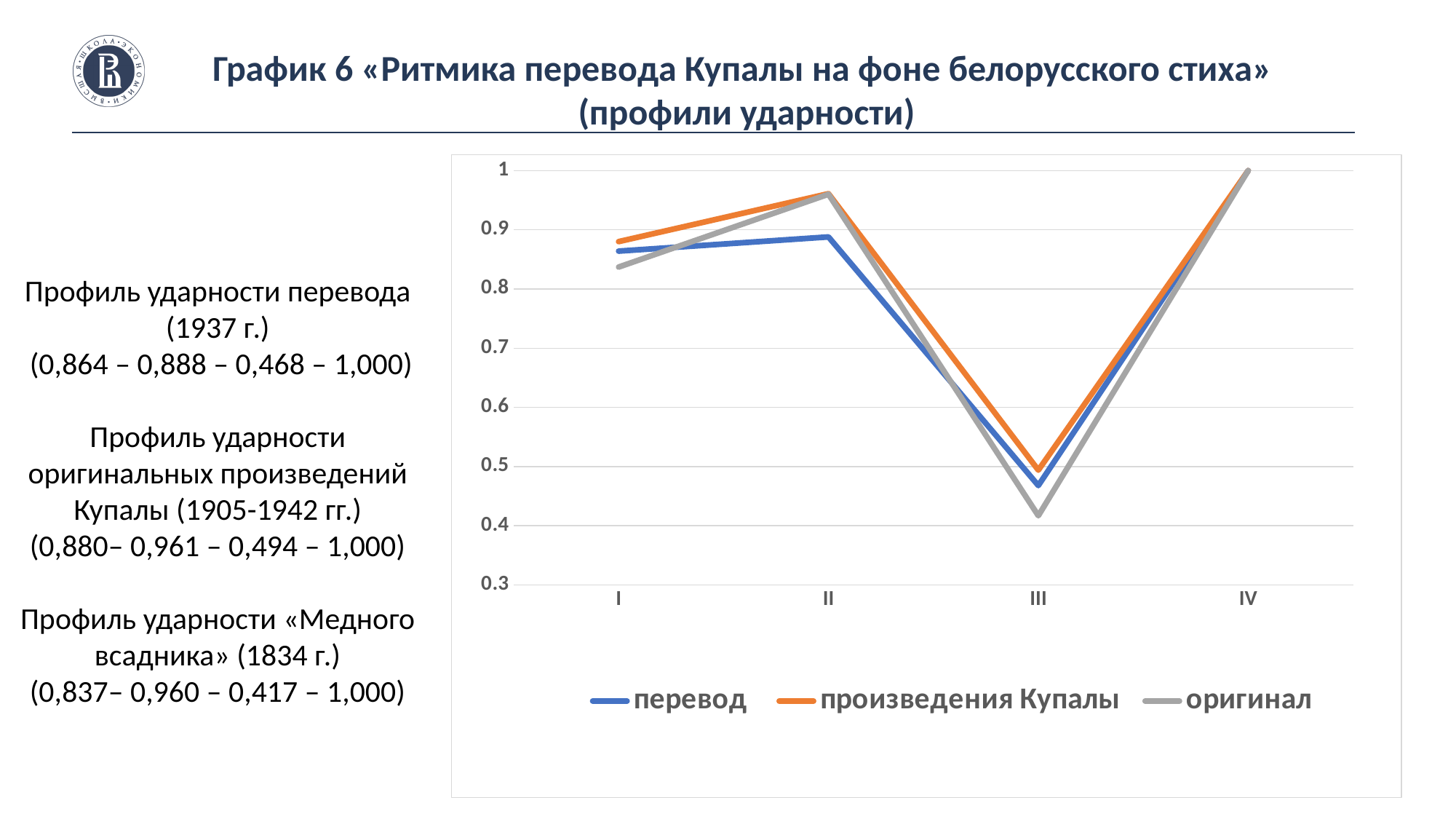
Which series has the lowest value at position III? оригинал What is the difference between the произведения Купалы and оригинал values at position III? 0,077 Do the values of all three series rise or fall from position II to position III? fall At which position does the оригинал series reach its lowest value? III Is the value of the перевод series at position III greater or less than 0.5? less What type of chart is shown on the slide? line chart How many series does the legend of the chart list? 3 At position II, which is larger: перевод or произведения Купалы? произведения Купалы What is the value of the перевод series at position III? 0,468 What is the value of the произведения Купалы series at position II? 0,961 How many positions are marked on the x axis of the chart? 4 What is the value of the оригинал series at position I? 0,837